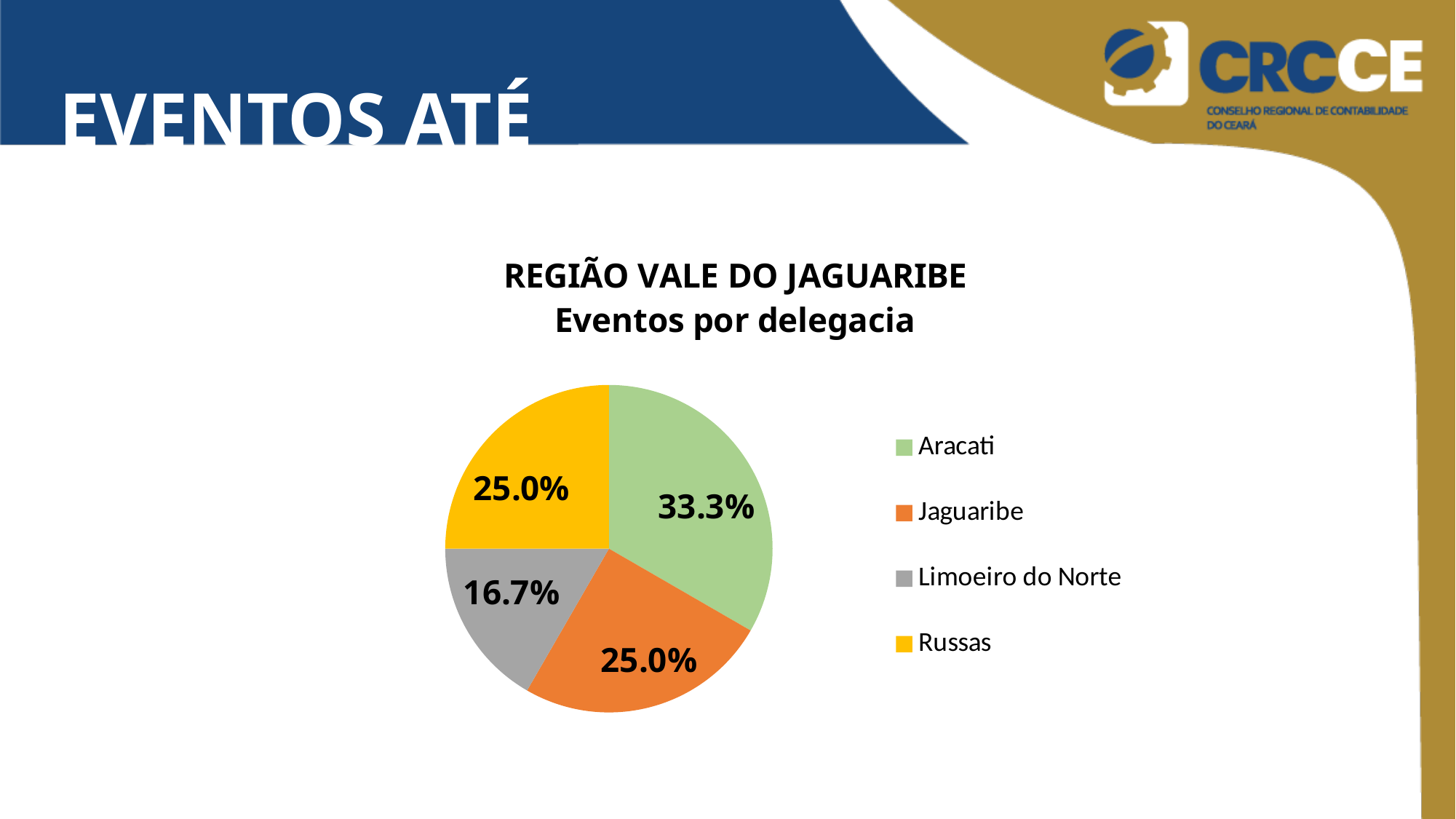
What share of the pie does Russas have? 25.0% What share of the pie does Jaguaribe have? 25.0% Which delegacia has the largest share of events? Aracati What type of chart is shown on the slide? Pie chart What share of the pie does Limoeiro do Norte have? 16.7% How many categories does the pie chart show? 4 What is the title of the chart? REGIÃO VALE DO JAGUARIBE Eventos por delegacia What share of the pie does Aracati have? 33.3% What is the difference in percentage points between Aracati's share and Limoeiro do Norte's share? 16.6 Which has a larger share, Aracati or Russas? Aracati Which colour represents Russas in the pie chart? Yellow Which delegacia has the smallest share of events? Limoeiro do Norte